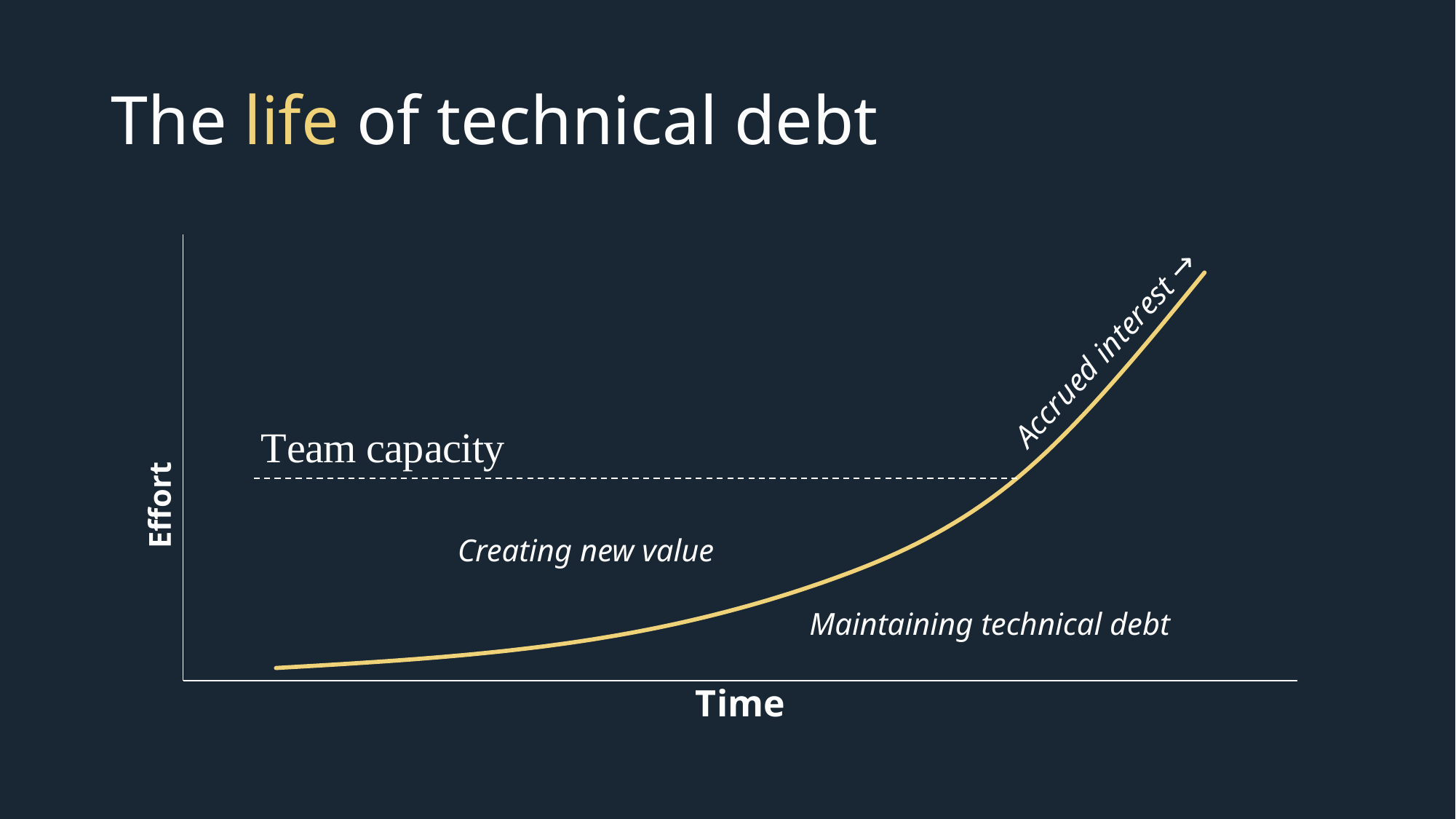
What is the title of the slide containing the chart? The life of technical debt Does the plotted curve rise or fall as time increases along the x axis? Rises What kind of chart is shown on the slide? Line chart At the right end of the curve, is the effort above or below the Team capacity line? Above What are the labels of the y axis and the x axis of the chart? Effort (y axis) and Time (x axis) At the left end of the curve, is the effort above or below the Team capacity line? Below